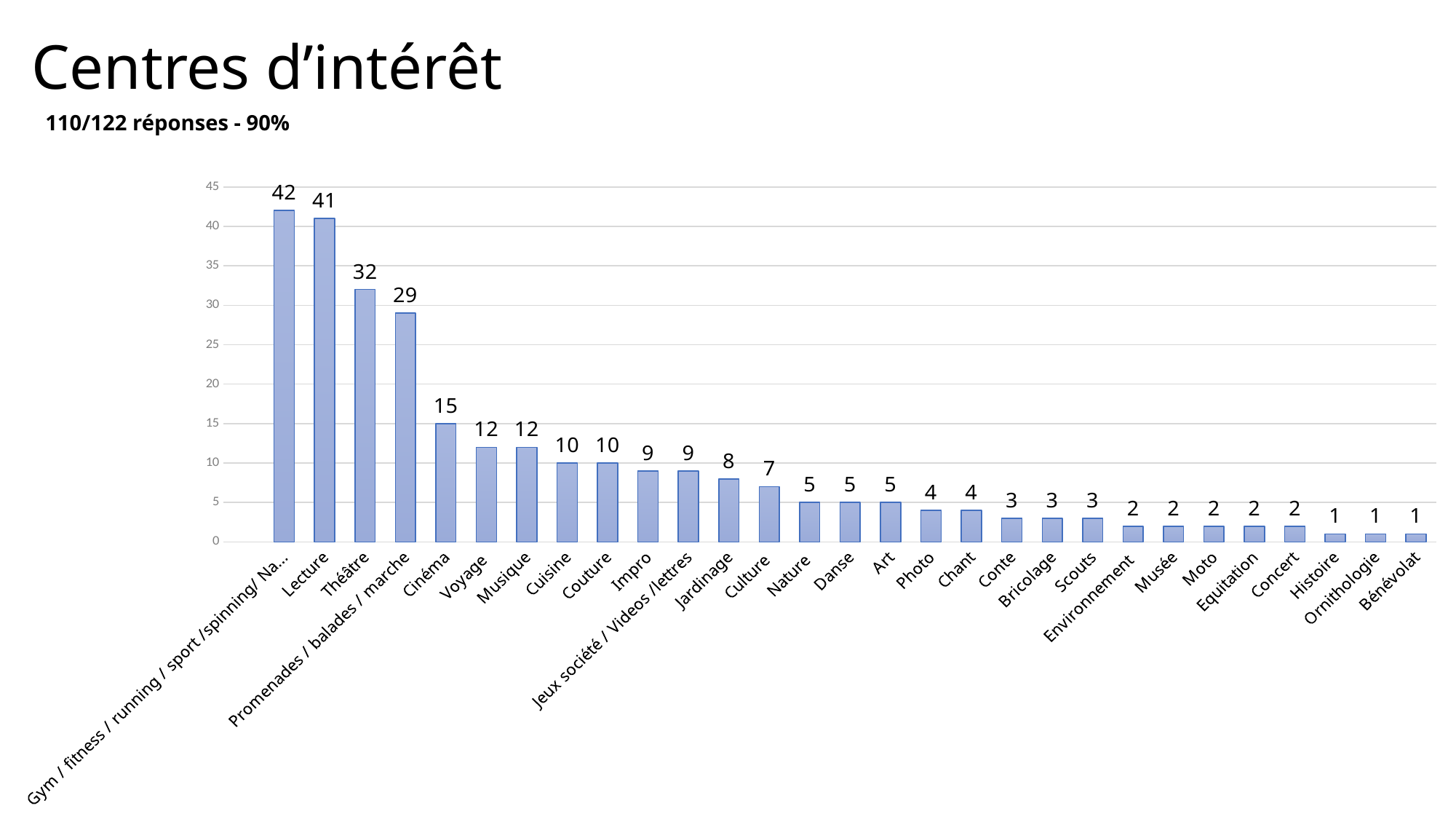
Do the values rise or fall from left to right along the x axis? fall What is the value for Cinéma? 15 What is the difference between the values for Lecture and Théâtre? 9 What is the value for Théâtre? 32 What is the value for Promenades / balades / marche? 29 What kind of chart is shown on the slide? bar chart What is the value for Lecture? 41 What is the title of the slide? Centres d'intérêt How many categories are shown on the chart? 29 What is the value for Jardinage? 8 Is the value for Promenades / balades / marche greater or less than 25? greater Which has a larger value, Voyage or Cuisine? Voyage